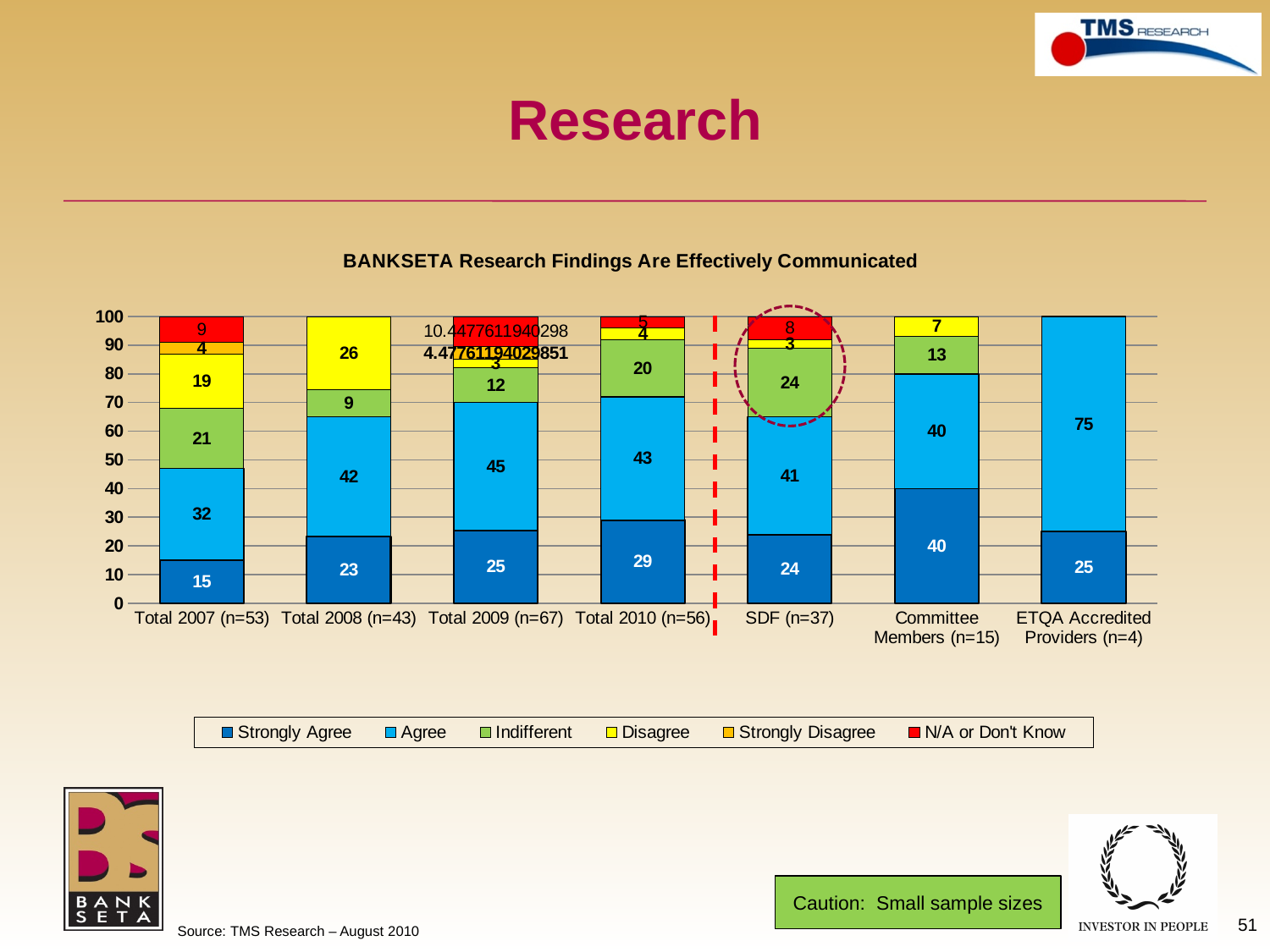
Which category has the highest Strongly Agree value? Committee Members (n=15) What is the Indifferent value for SDF (n=37)? 24 What is the Disagree value for Committee Members (n=15)? 7 What is the difference between the Agree values for Total 2009 (n=67) and Total 2008 (n=43)? 3 What kind of chart is shown on the slide? Stacked bar chart What is the Agree value for ETQA Accredited Providers (n=4)? 75 What is the title of the chart? BANKSETA Research Findings Are Effectively Communicated Which has the larger Disagree value, Total 2007 (n=53) or Total 2008 (n=43)? Total 2008 (n=43) What is the Strongly Agree value for Total 2010 (n=56)? 29 How many series does the legend list? 6 How many categories are shown along the x axis of the chart? 7 Which category has the lowest Strongly Agree value? Total 2007 (n=53)